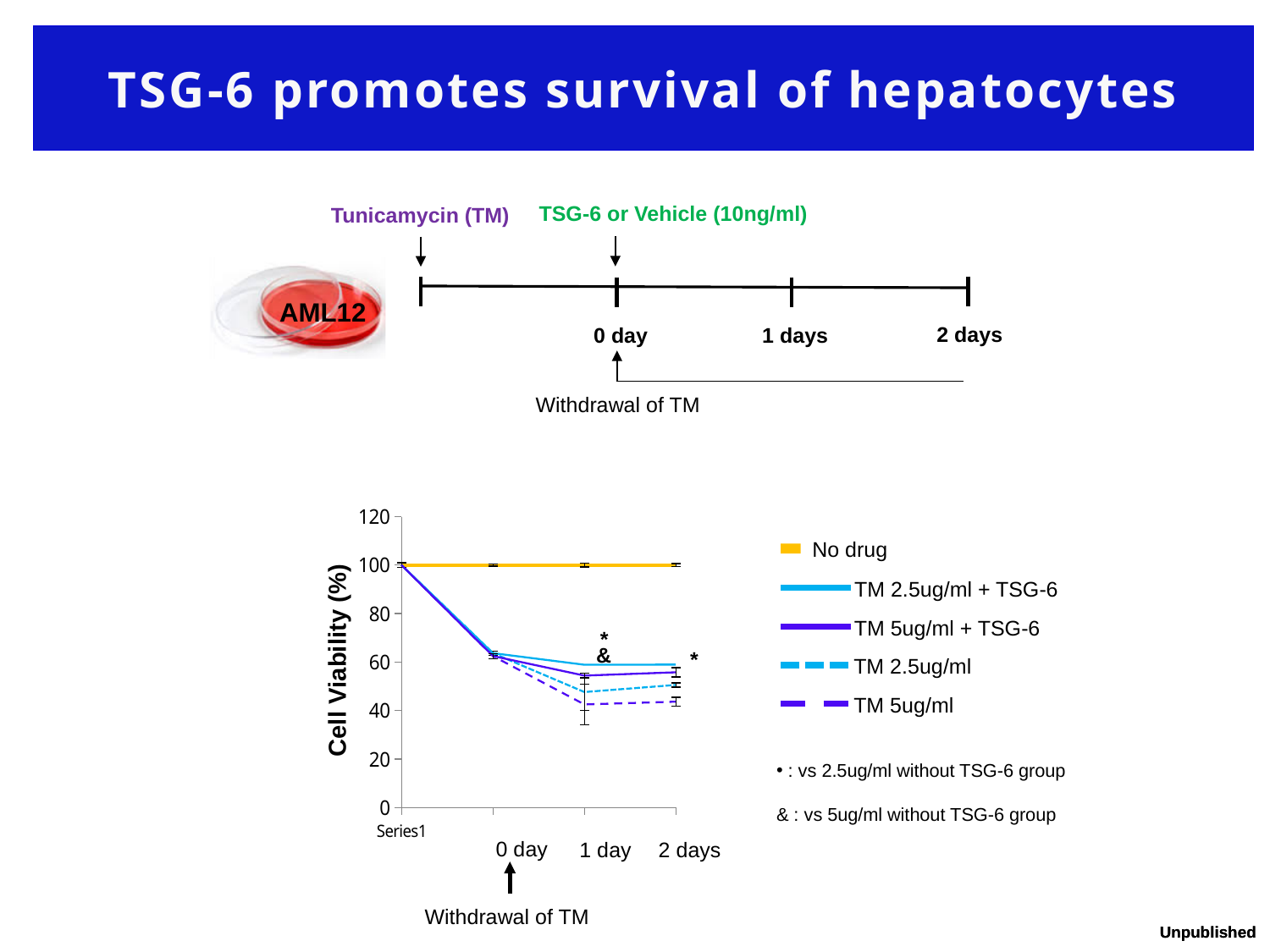
What is the title of the y axis? Cell Viability (%) What is the cell viability value for the No drug series at 2 days? 100 At 1 day, which is larger: TM 2.5ug/ml + TSG-6 or TM 5ug/ml? TM 2.5ug/ml + TSG-6 Which legend entry is shown in yellow? No drug How many series does the chart's legend list? 5 What kind of chart is shown on the slide? line chart Is the value for TM 5ug/ml at 1 day greater or less than 60? less Does the TM 5ug/ml series rise or fall from Series1 to 1 day? fall Is the value for TM 2.5ug/ml + TSG-6 at 2 days greater or less than 40? greater Is the value for TM 5ug/ml + TSG-6 at 2 days greater or less than 80? less Which series has the lowest value at 1 day? TM 5ug/ml Which series has the highest value at 2 days? No drug